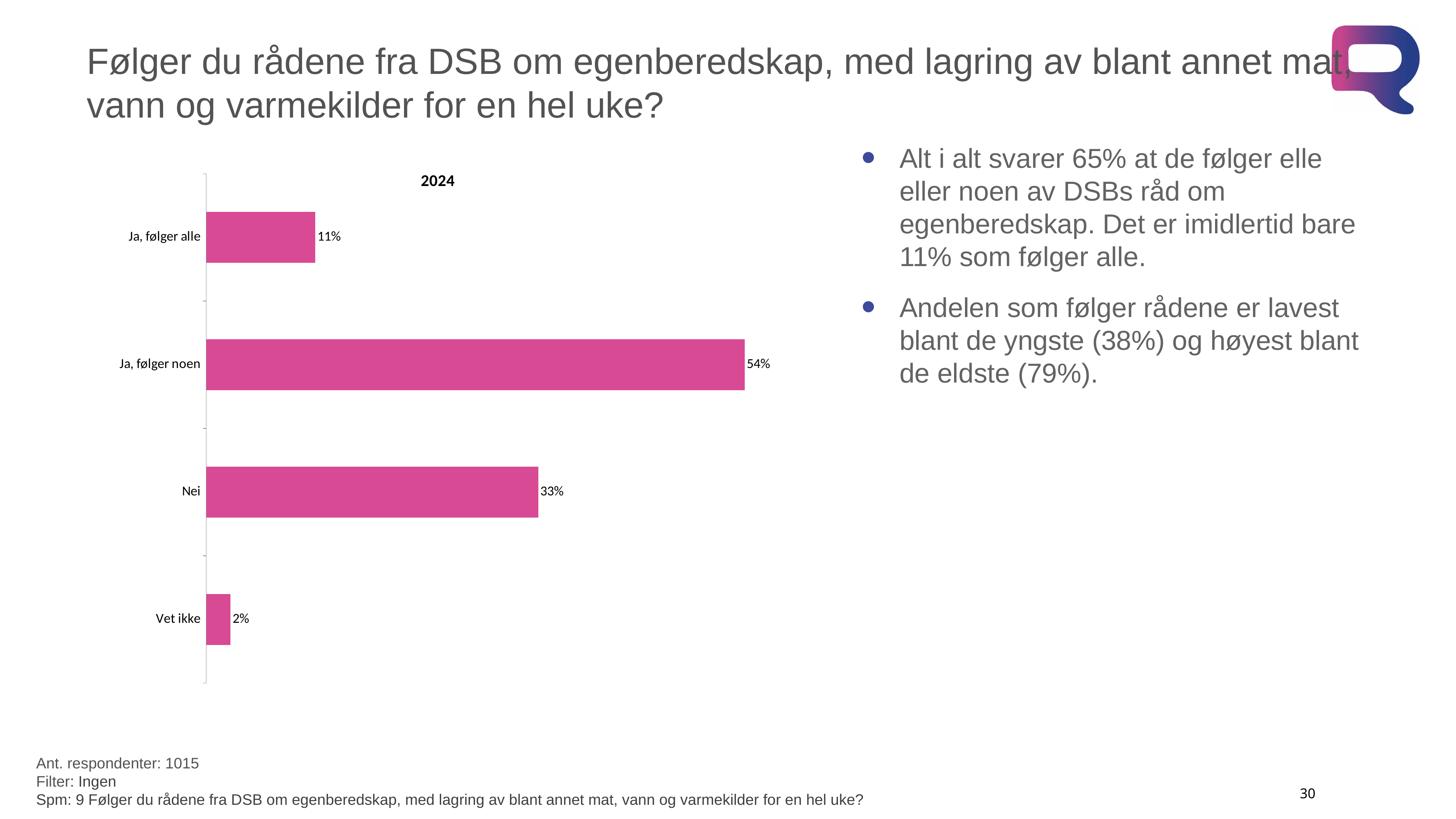
What is the title of the chart? 2024 What kind of chart is shown on the slide? Bar chart How many categories are shown in the chart? 4 What is the value for "Ja, følger noen"? 54% What is the value for "Ja, følger alle"? 11% What is the difference between the values for "Ja, følger noen" and "Nei"? 21% Which is larger, the value for "Nei" or the value for "Ja, følger alle"? Nei What is the difference between the values for "Ja, følger alle" and "Vet ikke"? 9% Which category has the lowest value? Vet ikke What is the value for "Vet ikke"? 2% Which category has the highest value? Ja, følger noen What is the value for "Nei"? 33%